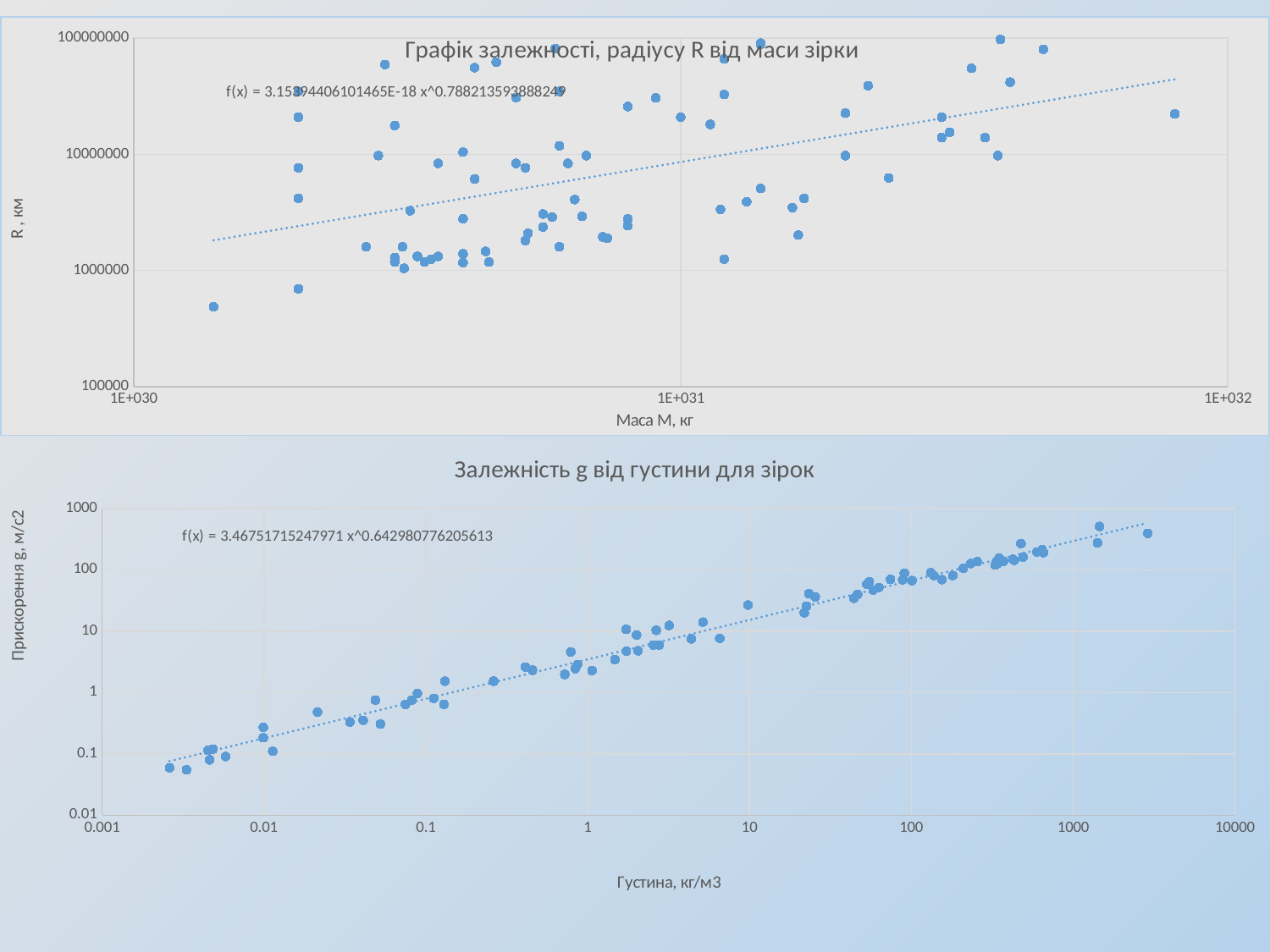
In the bottom chart "Залежність g від густини для зірок", is the lowest plotted value of g greater or less than 0.1? less In the top chart "Графік залежності, радіусу R від маси зірки", does the trendline rise or fall as mass increases along the x axis? rise What is the title of the bottom chart on the slide? Залежність g від густини для зірок In the top chart "Графік залежності, радіусу R від маси зірки", is the highest plotted value of R greater or less than 10000000? greater In the bottom chart "Залежність g від густини для зірок", is the highest plotted value of g greater or less than 100? greater What is the y-axis label of the top chart "Графік залежності, радіусу R від маси зірки"? R , км What kind of chart is the bottom chart titled "Залежність g від густини для зірок"? scatter chart In the bottom chart "Залежність g від густини для зірок", do the values of g rise or fall as density increases along the x axis? rise What kind of chart is the top chart titled "Графік залежності, радіусу R від маси зірки"? scatter chart